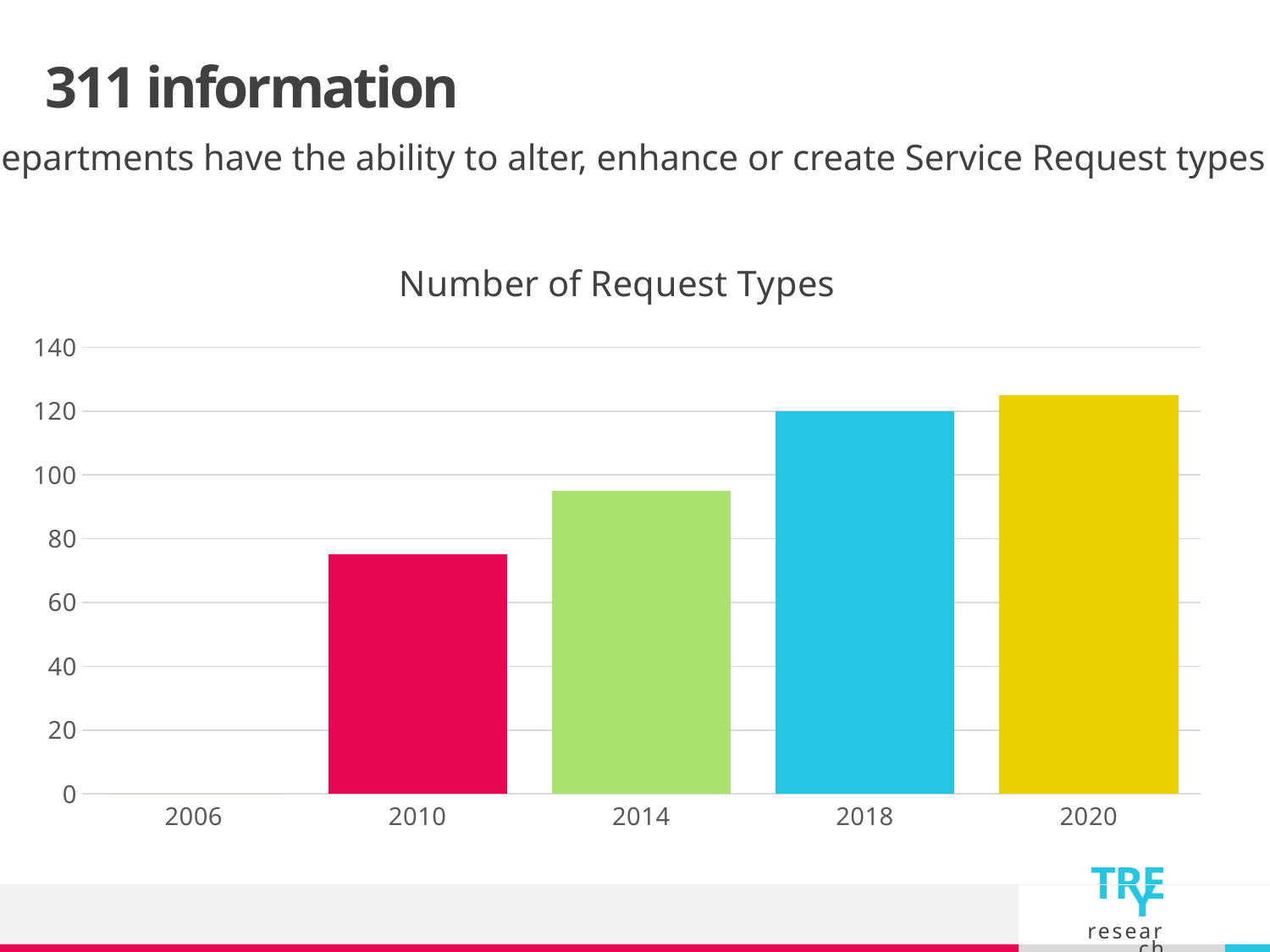
Is the value for 2014 greater or less than 100? less Is the value for 2010 greater or less than 80? less Which year has more request types, 2010 or 2014? 2014 Which year has the highest number of request types? 2020 How many years are shown on the x axis of the chart? 5 Which year has the lowest number of request types? 2006 Is the value for 2020 greater or less than 140? less What type of chart is shown on the slide? bar chart What is the title of the chart? Number of Request Types Do the number of request types rise or fall from 2006 to 2020? rise